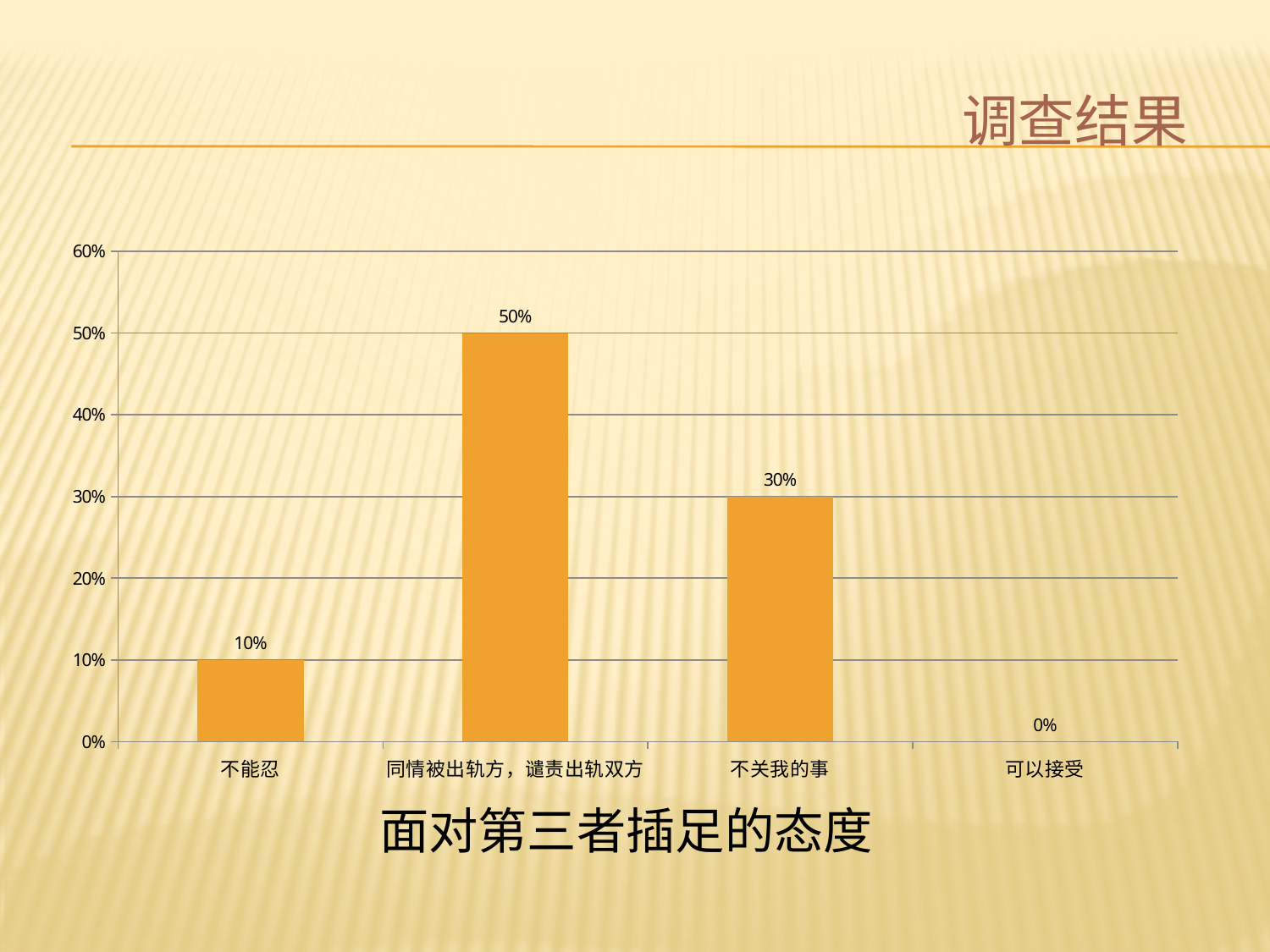
Which category has the lowest value? 可以接受 What is the value for 同情被出轨方，谴责出轨双方? 50% What is the title of the chart? 面对第三者插足的态度 What is the value for 不能忍? 10% What kind of chart is shown on the slide? bar chart Which is larger, the value for 不关我的事 or the value for 不能忍? 不关我的事 What is the value for 不关我的事? 30% How many categories are shown on the x axis? 4 What is the value for 可以接受? 0% Is the value for 同情被出轨方，谴责出轨双方 greater or less than 40%? greater Which category has the highest value? 同情被出轨方，谴责出轨双方 What is the difference between the values for 同情被出轨方，谴责出轨双方 and 不关我的事? 20%